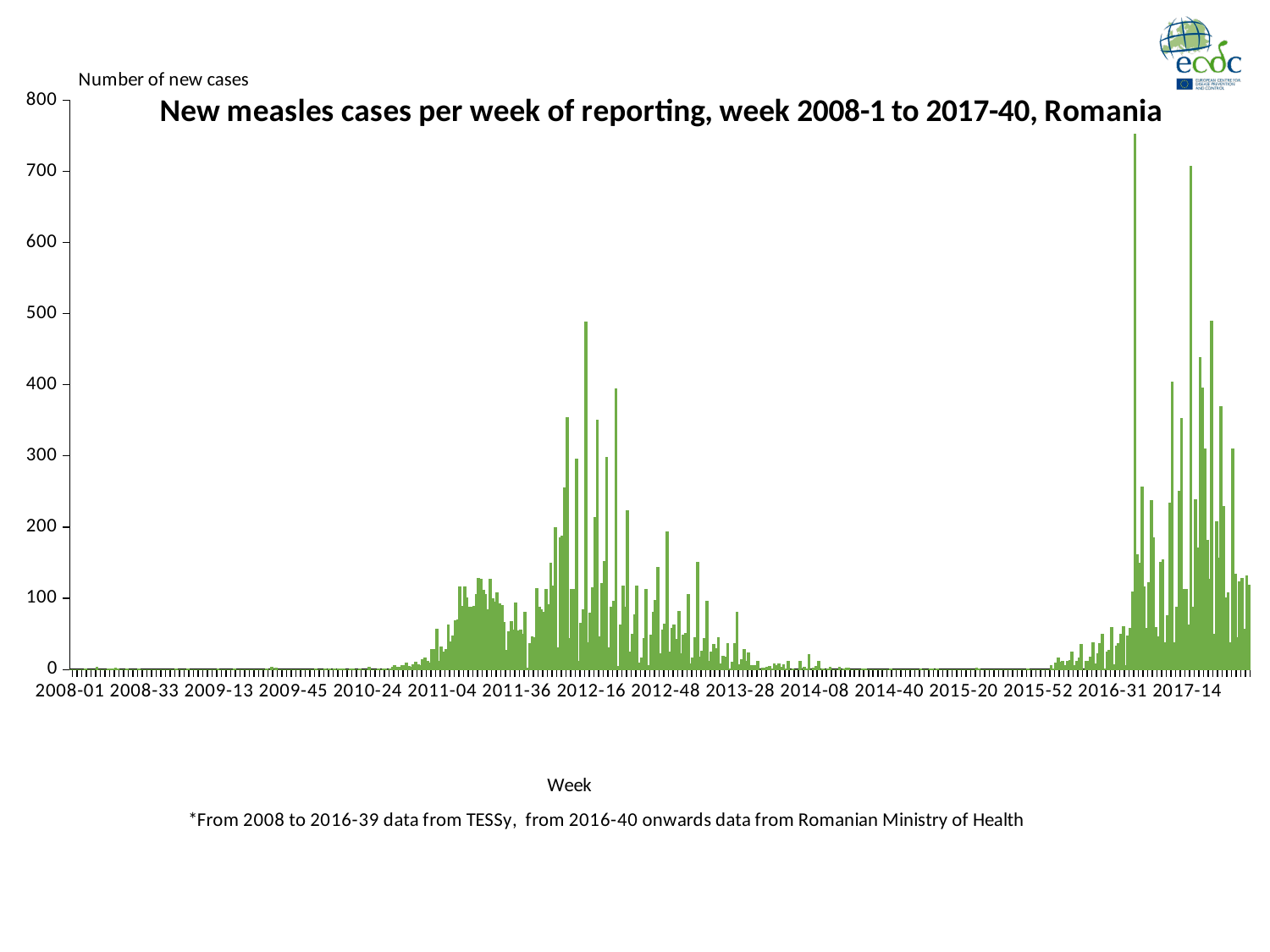
How many week labels are printed along the horizontal axis? 16 Is the value for week 2008-01 greater or less than 100? less What is the highest value shown on the vertical axis? 800 Which outbreak period has the higher peak weekly value: the one around 2012 or the one around 2016-2017? 2016-2017 Do the weekly values rise or fall between week 2012-16 and week 2013-28? fall Is the value for week 2014-40 greater or less than 100? less Is the tallest bar in the chart greater or less than 700? greater What is the title of the chart? New measles cases per week of reporting, week 2008-1 to 2017-40, Romania What is the label of the vertical axis? Number of new cases What kind of chart is shown on the slide? Bar chart